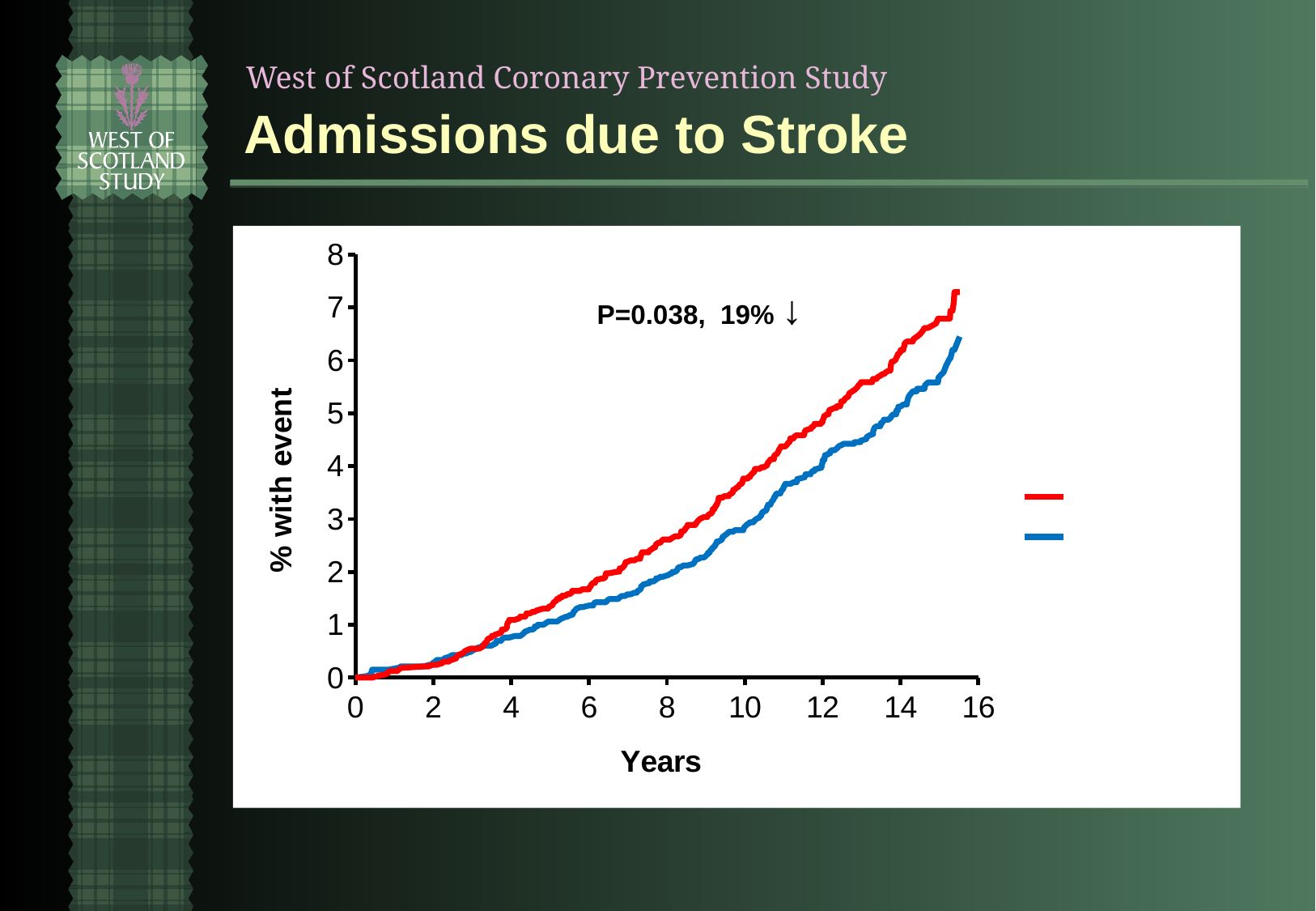
At 10 years, which line shows the higher % with event, red or blue? Red What is the title of the slide containing the chart? Admissions due to Stroke What P-value is printed on the chart? P=0.038 Do the values of the red line rise or fall as the years increase? Rise Which line reaches the higher % with event at the end of follow-up, red or blue? Red Do the values of the blue line rise or fall as the years increase? Rise What kind of chart is shown on the slide? Line chart At 12 years, which line shows the lower % with event, red or blue? Blue Is the value for the blue line at 6 years greater or less than 2? less Is the value for the red line at 8 years greater or less than 2? greater How many series does the legend list? 2